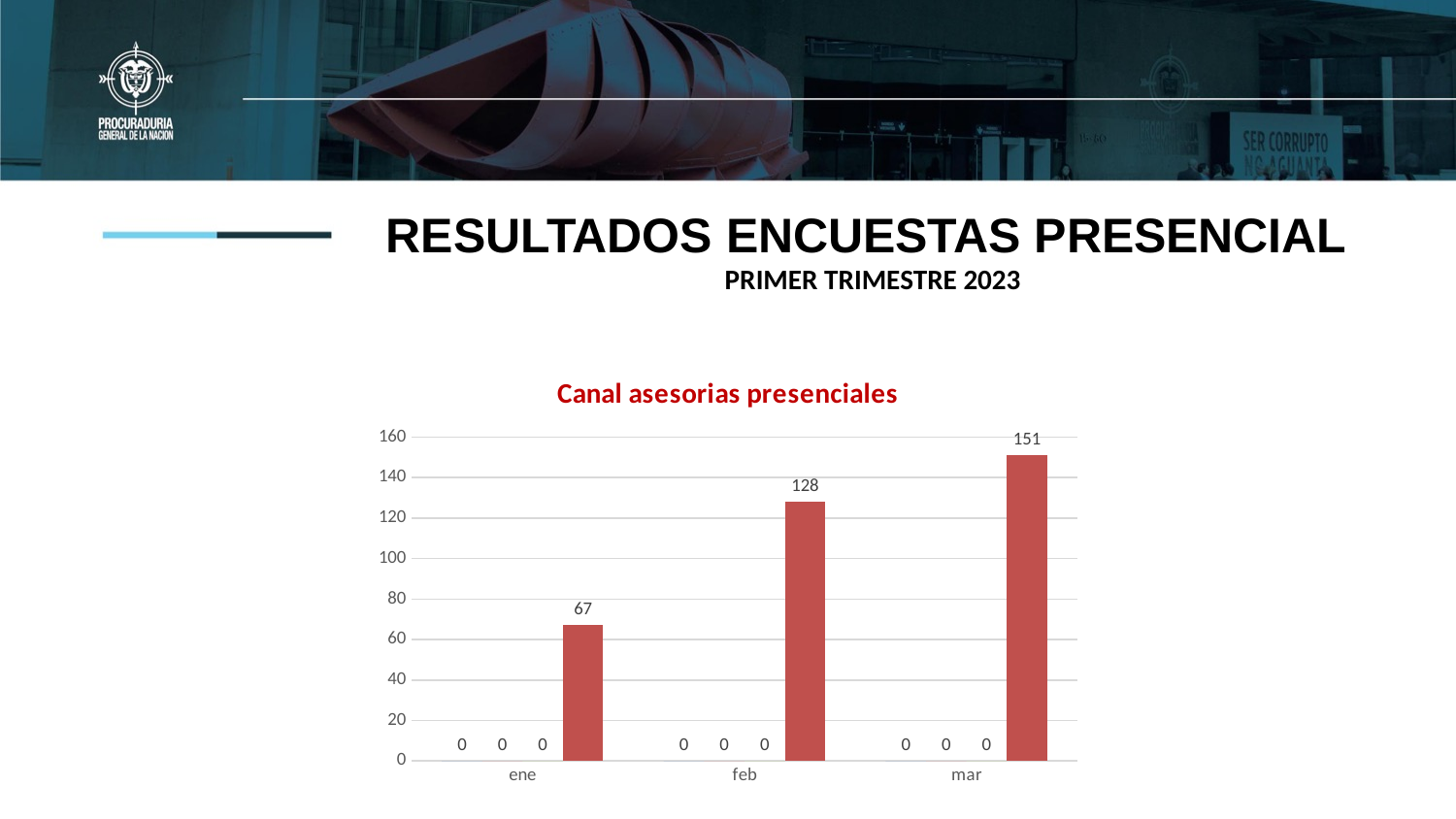
What is the difference between the red bar values for mar and feb in the 'Canal asesorias presenciales' chart? 23 How many months are shown on the x axis of the 'Canal asesorias presenciales' chart? 3 Which month has the highest red bar in the 'Canal asesorias presenciales' chart? mar What is the value of the red bar for ene in the 'Canal asesorias presenciales' chart? 67 Which month has the lowest red bar in the 'Canal asesorias presenciales' chart? ene What is the title of the chart on the slide? Canal asesorias presenciales Do the red bar values rise or fall from ene to mar in the 'Canal asesorias presenciales' chart? rise What is the difference between the red bar values for feb and ene in the 'Canal asesorias presenciales' chart? 61 Is the red bar for feb or the red bar for mar larger in the 'Canal asesorias presenciales' chart? mar What kind of chart is 'Canal asesorias presenciales'? bar chart What is the value of the red bar for feb in the 'Canal asesorias presenciales' chart? 128 What is the value of the red bar for mar in the 'Canal asesorias presenciales' chart? 151